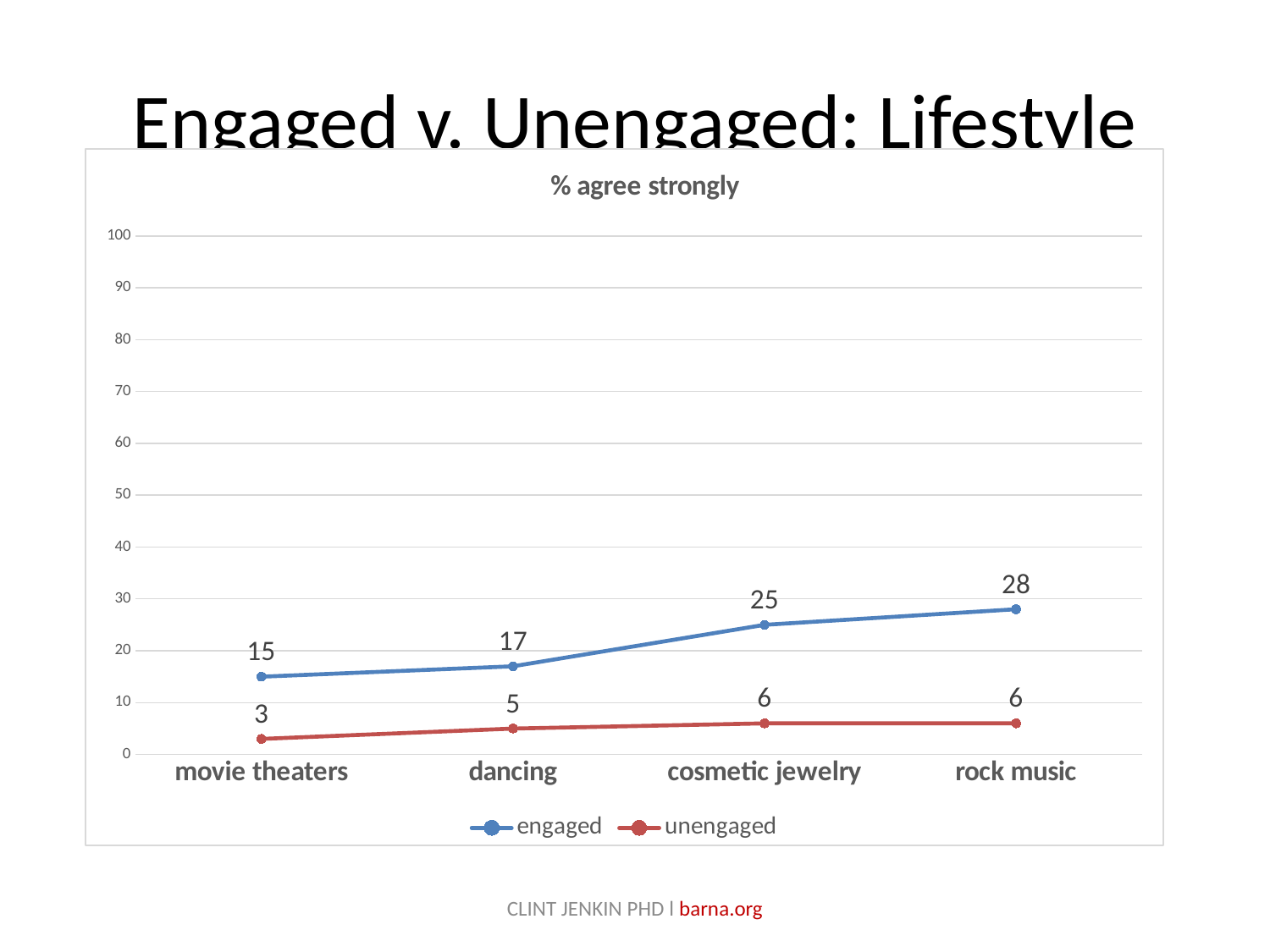
Is the value for engaged at rock music greater or less than 30? less How many categories are shown on the x axis? 4 Does the engaged series rise or fall from movie theaters to rock music? rise How many series does the legend list? 2 What is the difference between the engaged and unengaged values at rock music? 22 What is the value for engaged at dancing? 17 Which is larger, the engaged value at movie theaters or the engaged value at dancing? dancing Which category has the highest value for the engaged series? rock music What is the value for unengaged at movie theaters? 3 What kind of chart is shown? line chart Which category has the lowest value for the unengaged series? movie theaters What is the value for engaged at cosmetic jewelry? 25